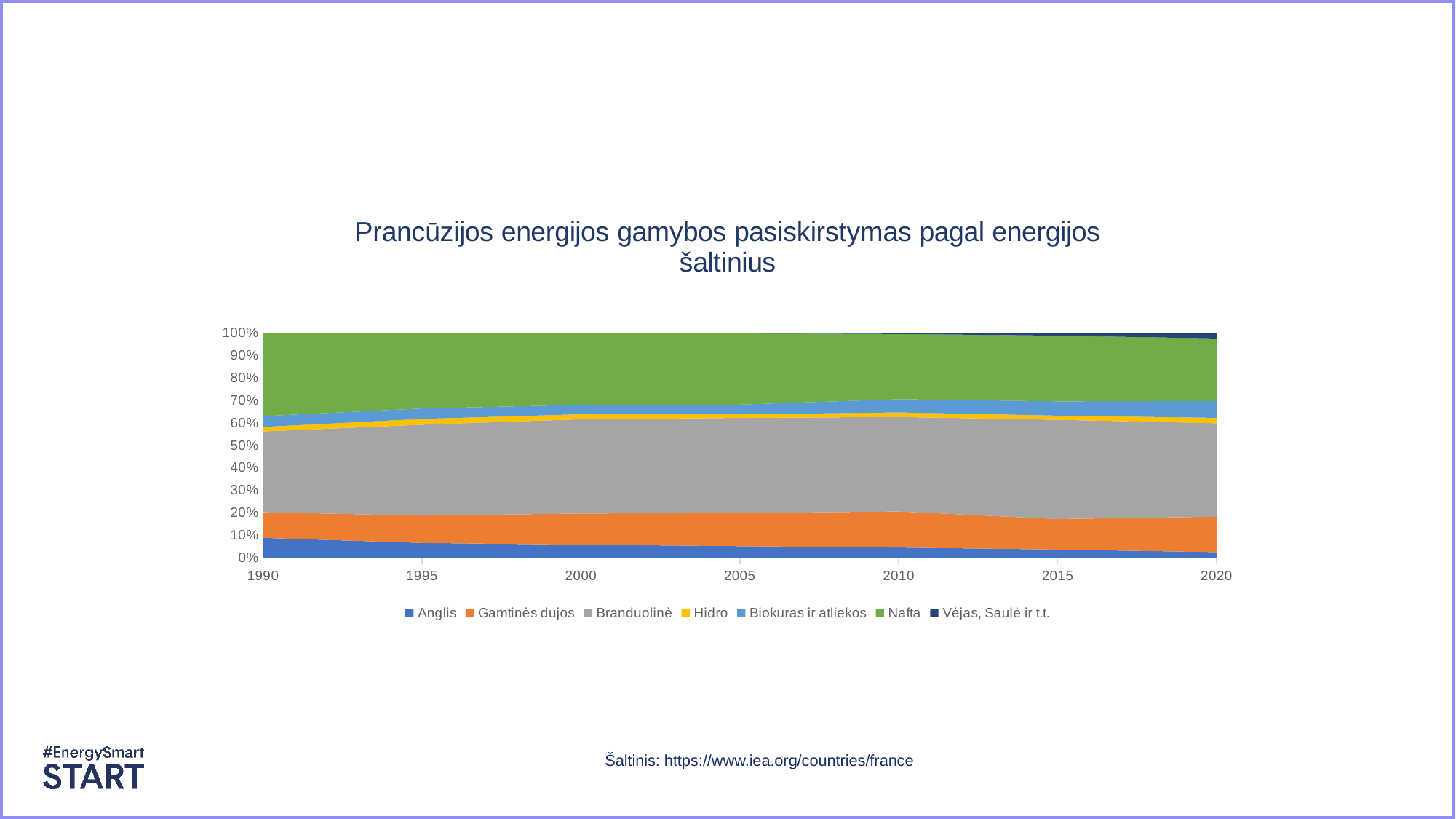
What is the first year shown on the x axis? 1990 What kind of chart is shown on the slide? Stacked area chart How many series does the legend list? 7 Is the value for Anglis in 2020 greater or less than 10%? less Which series is shown in green in the chart? Nafta Which series has the largest share in 2020, Branduolinė or Hidro? Branduolinė Does the share of Anglis rise or fall from 1990 to 2020? Fall What is the title of the chart? Prancūzijos energijos gamybos pasiskirstymas pagal energijos šaltinius What is the last year shown on the x axis? 2020 Does the share of Nafta rise or fall from 1990 to 2020? Fall Is the value for Anglis in 1990 greater or less than 20%? less